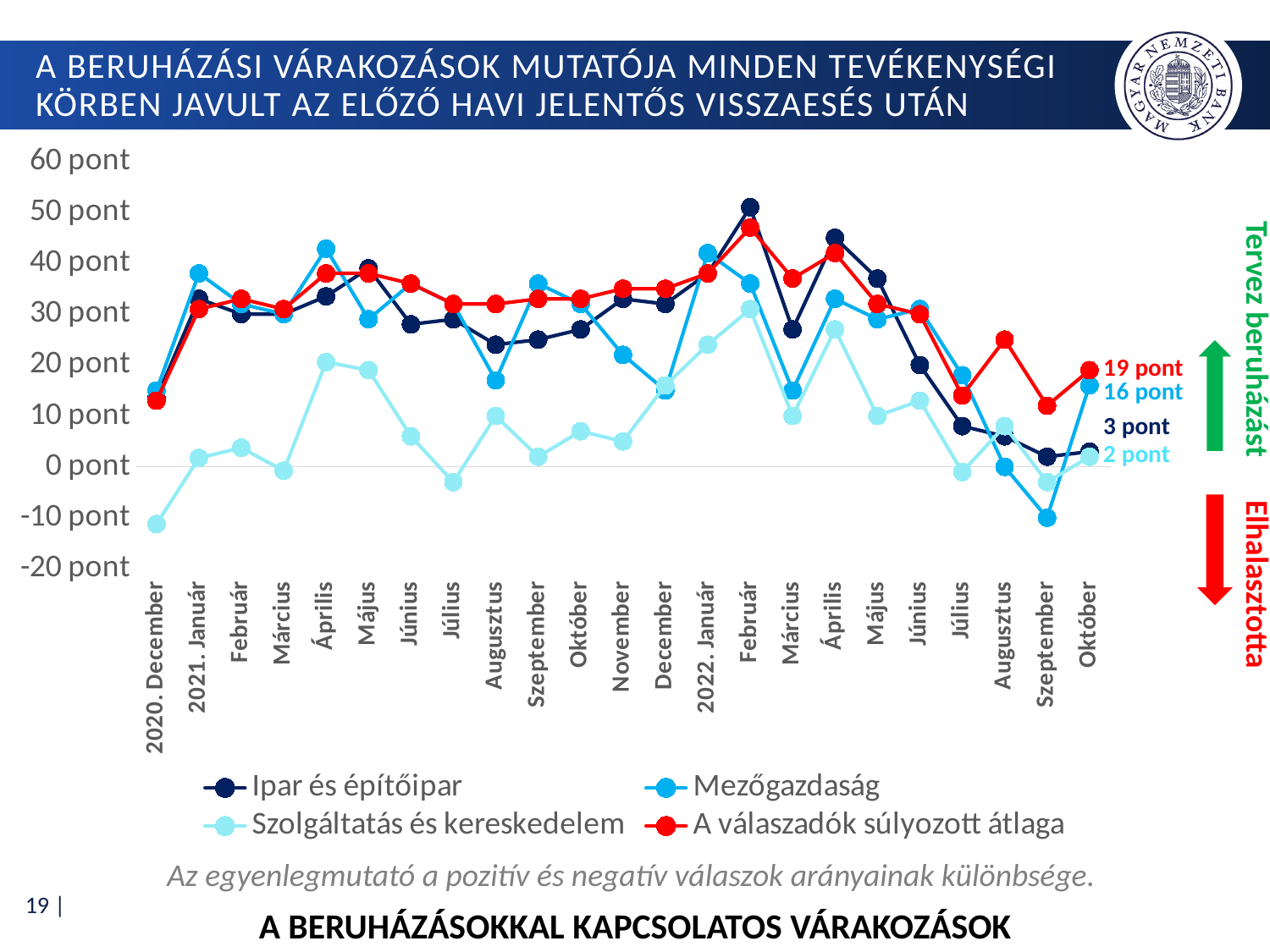
Which series has the lowest value in Október 2022? Szolgáltatás és kereskedelem How many months (data points) are shown along the x axis? 23 Which series has the highest value in Október 2022? A válaszadók súlyozott átlaga What is the value of 'Szolgáltatás és kereskedelem' in Október 2022? 2 pont What is the value of 'Ipar és építőipar' in Október 2022? 3 pont What kind of chart is shown on the slide? line chart What is the difference between 'A válaszadók súlyozott átlaga' and 'Mezőgazdaság' in Október 2022? 3 pont How many series does the legend list? 4 Is the value for 'Ipar és építőipar' in Február 2022 greater or less than 40 pont? greater What is the value of 'Mezőgazdaság' in Október 2022? 16 pont What is the value of 'A válaszadók súlyozott átlaga' in Október 2022? 19 pont Is the value for 'Szolgáltatás és kereskedelem' in 2020. December greater or less than 0 pont? less